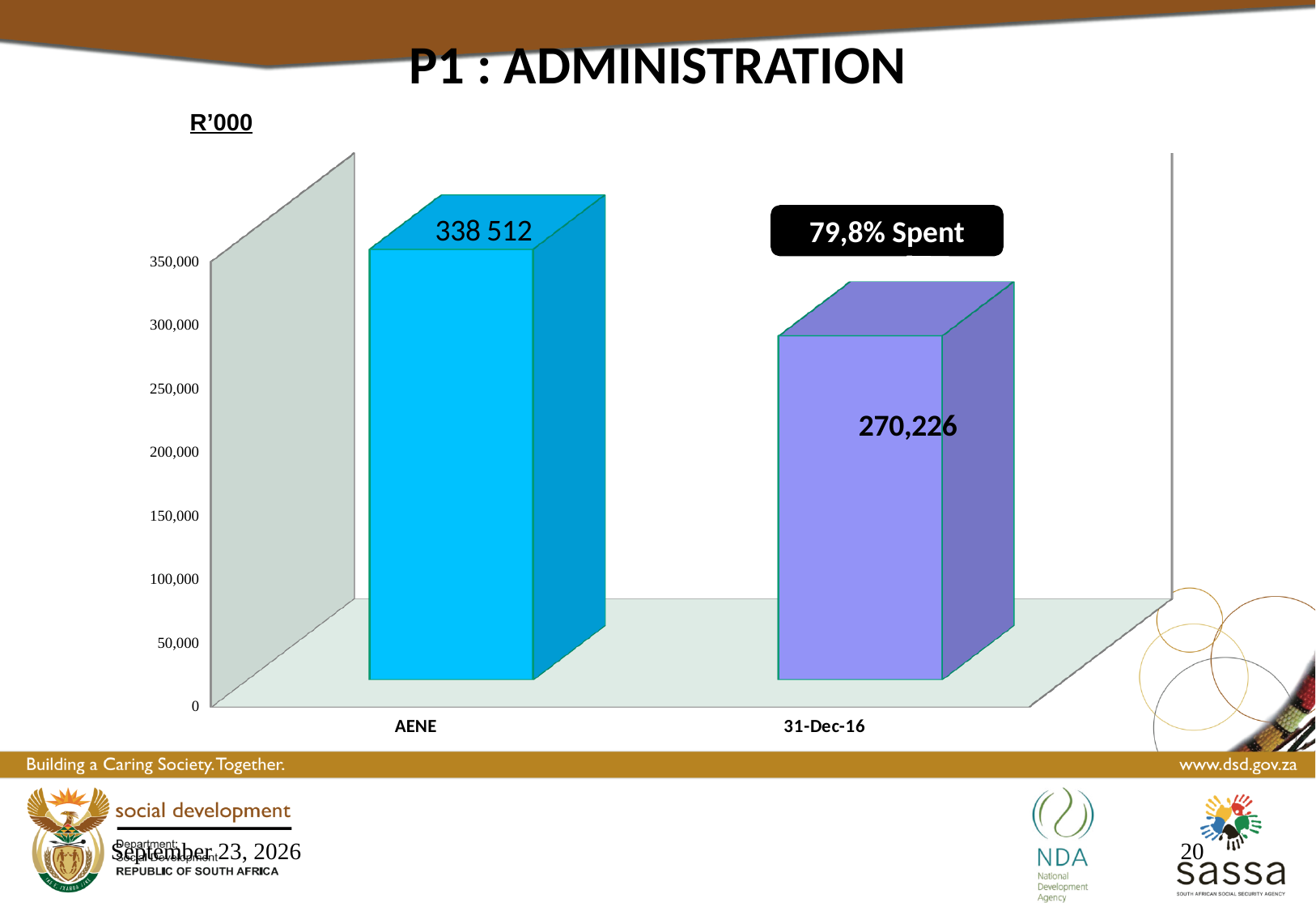
Is the value for 31-Dec-16 greater or less than 300,000? less What kind of chart is shown on the slide? bar chart What is the value for 31-Dec-16? 270,226 Which category has the lowest value? 31-Dec-16 What is the difference between the AENE value and the 31-Dec-16 value? 68,286 Which category has the highest value? AENE Is the value for AENE greater or less than 300,000? greater Which is larger, the value for AENE or the value for 31-Dec-16? AENE What unit is indicated above the chart? R'000 What is the value for AENE? 338 512 How many categories are shown on the x axis? 2 What percentage spent is annotated on the chart? 79,8% Spent